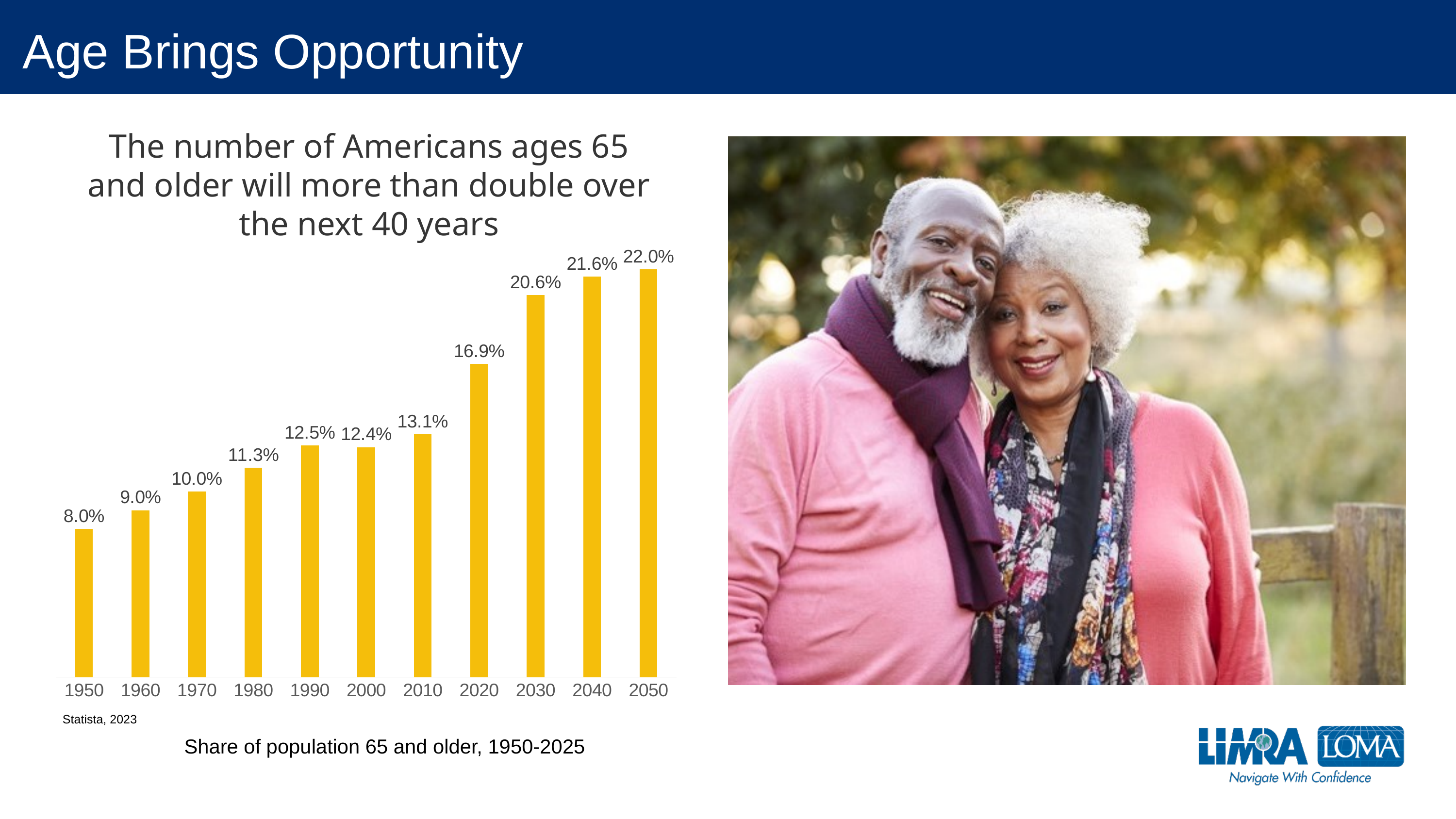
Which year has the highest value in the chart? 2050 Which is larger, the value for 1990 or the value for 2000? 1990 What kind of chart is shown on the slide? Bar chart Which year has the lowest value in the chart? 1950 What is the share of population 65 and older shown for 1950? 8.0% What colour are the bars in the chart? Yellow How many years (bars) are shown in the chart? 11 What value is shown for 2030? 20.6% What value is shown for 2020? 16.9% What is the difference between the values for 2020 and 2010? 3.8% Do the values generally rise or fall from 1950 to 2050? Rise What is the difference between the values for 2050 and 1950? 14.0%